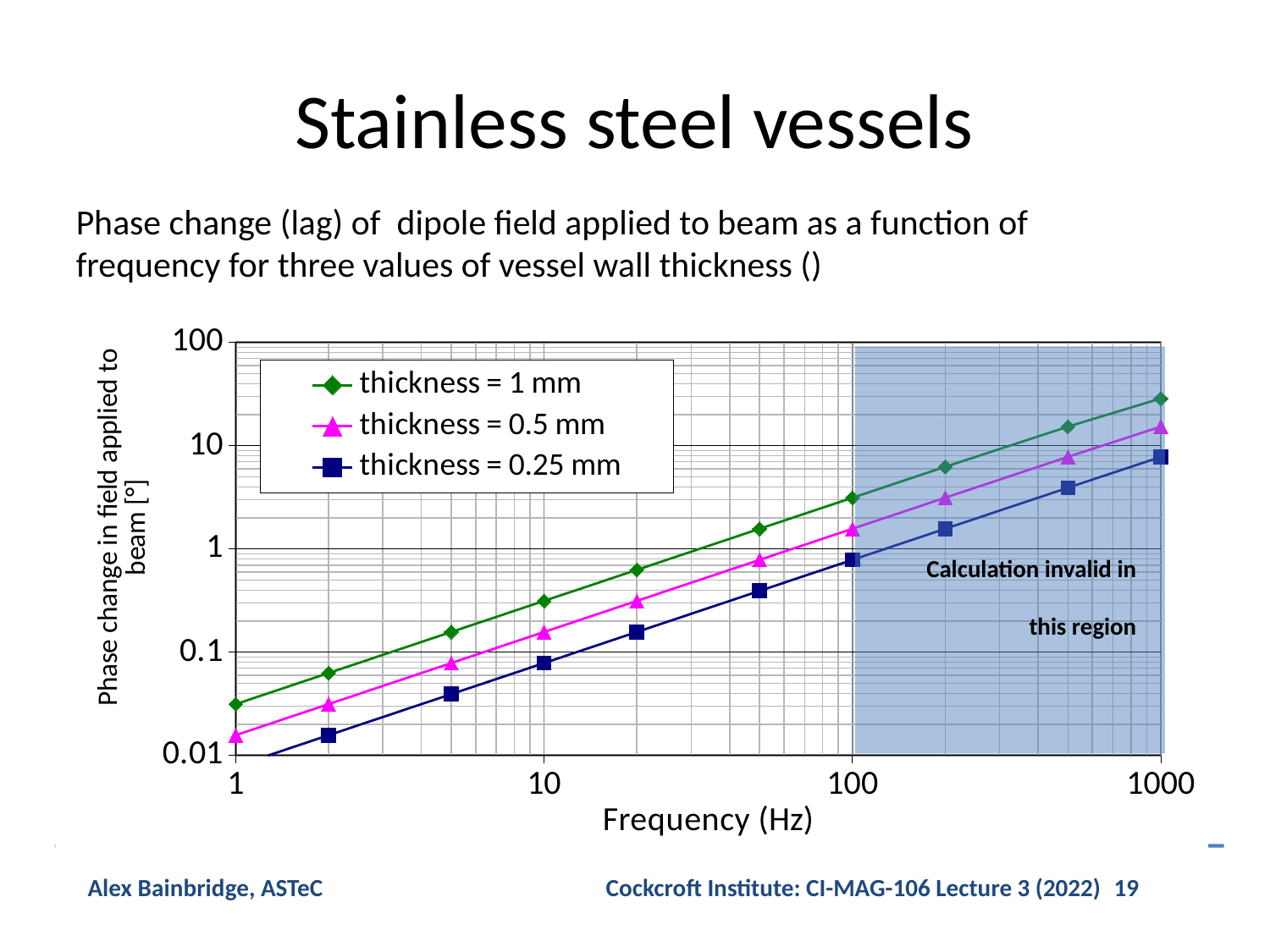
What does the text in the shaded region of the chart say? Calculation invalid in this region At 10 Hz, which series has the larger phase change: thickness = 1 mm or thickness = 0.25 mm? thickness = 1 mm Is the value for thickness = 1 mm at 1000 Hz greater or less than 10? greater How many data points are plotted for the thickness = 1 mm series? 10 Which series has the highest phase change at 1000 Hz? thickness = 1 mm What are the three series named in the legend? thickness = 1 mm, thickness = 0.5 mm, thickness = 0.25 mm Do the phase change values rise or fall as frequency increases? rise What kind of chart is shown on the slide? line chart How many series does the legend list? 3 Is the value for thickness = 1 mm at 100 Hz greater or less than 1? greater Which series has the lowest phase change at 1 Hz? thickness = 0.25 mm Is the value for thickness = 0.5 mm at 1 Hz greater or less than 0.1? less